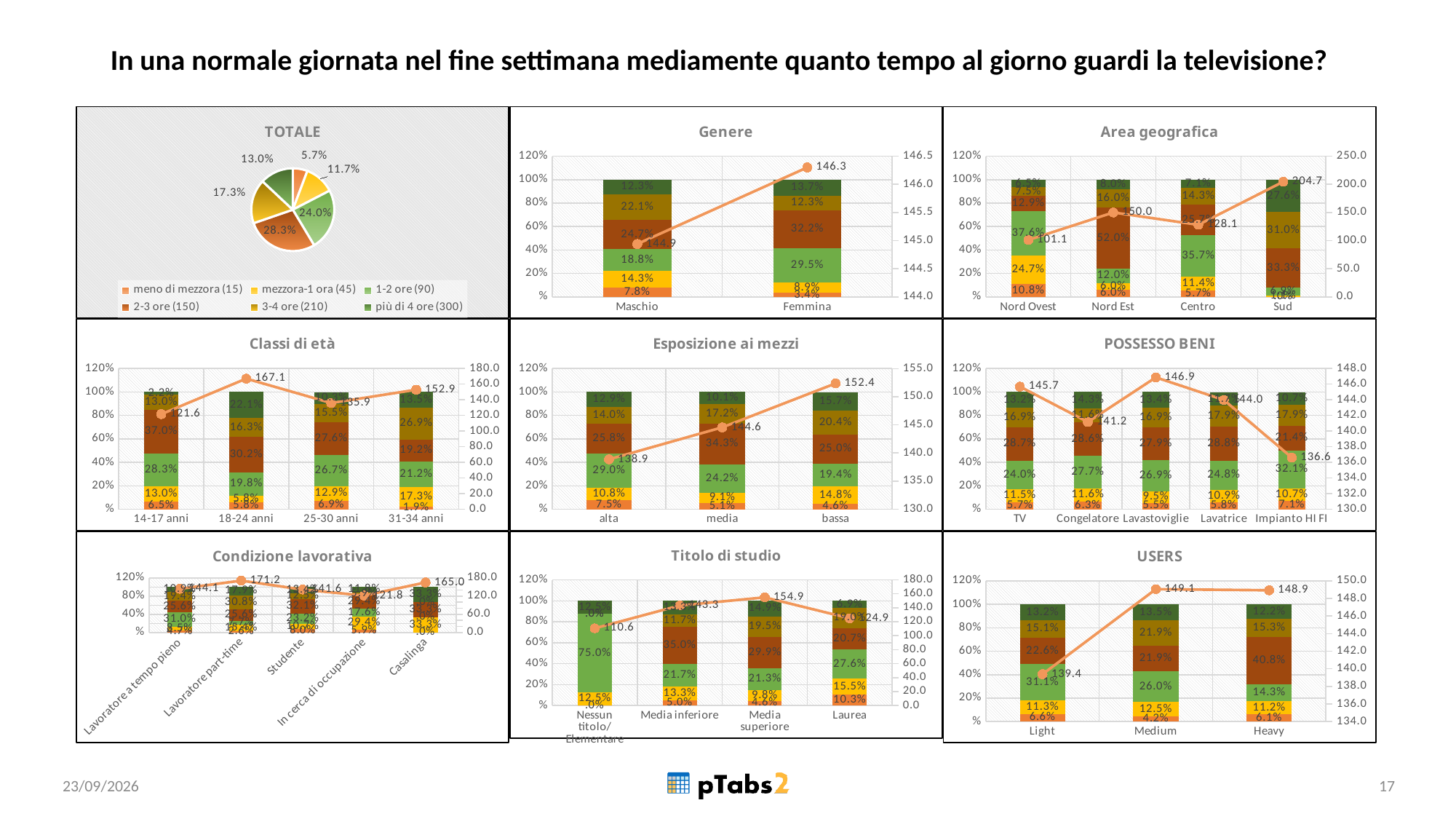
In the Area geografica chart, what is the difference between the line values for Sud and Nord Ovest? 103.6 In the USERS chart, what is the line value for Light? 139.4 In the Esposizione ai mezzi chart, do the line values rise or fall from alta to bassa? rise In the POSSESSO BENI chart, how many categories are shown on the x axis? 5 How many entries does the legend of the TOTALE pie chart list? 6 In the Classi di età chart, which age class has the lowest line value? 14-17 anni In the Titolo di studio chart, what is the largest segment value for 'Nessun titolo/Elementare'? 75.0% In the Genere chart, what is the line value for Femmina? 146.3 In the TOTALE pie chart, what share is shown for the '2-3 ore (150)' slice? 28.3% In the POSSESSO BENI chart, which is larger, the line value for Lavastoviglie or for Impianto HI FI? Lavastoviglie In the Genere chart, what is the '2-3 ore' segment value for Maschio? 24.7% In the Area geografica chart, which category has the highest line value? Sud